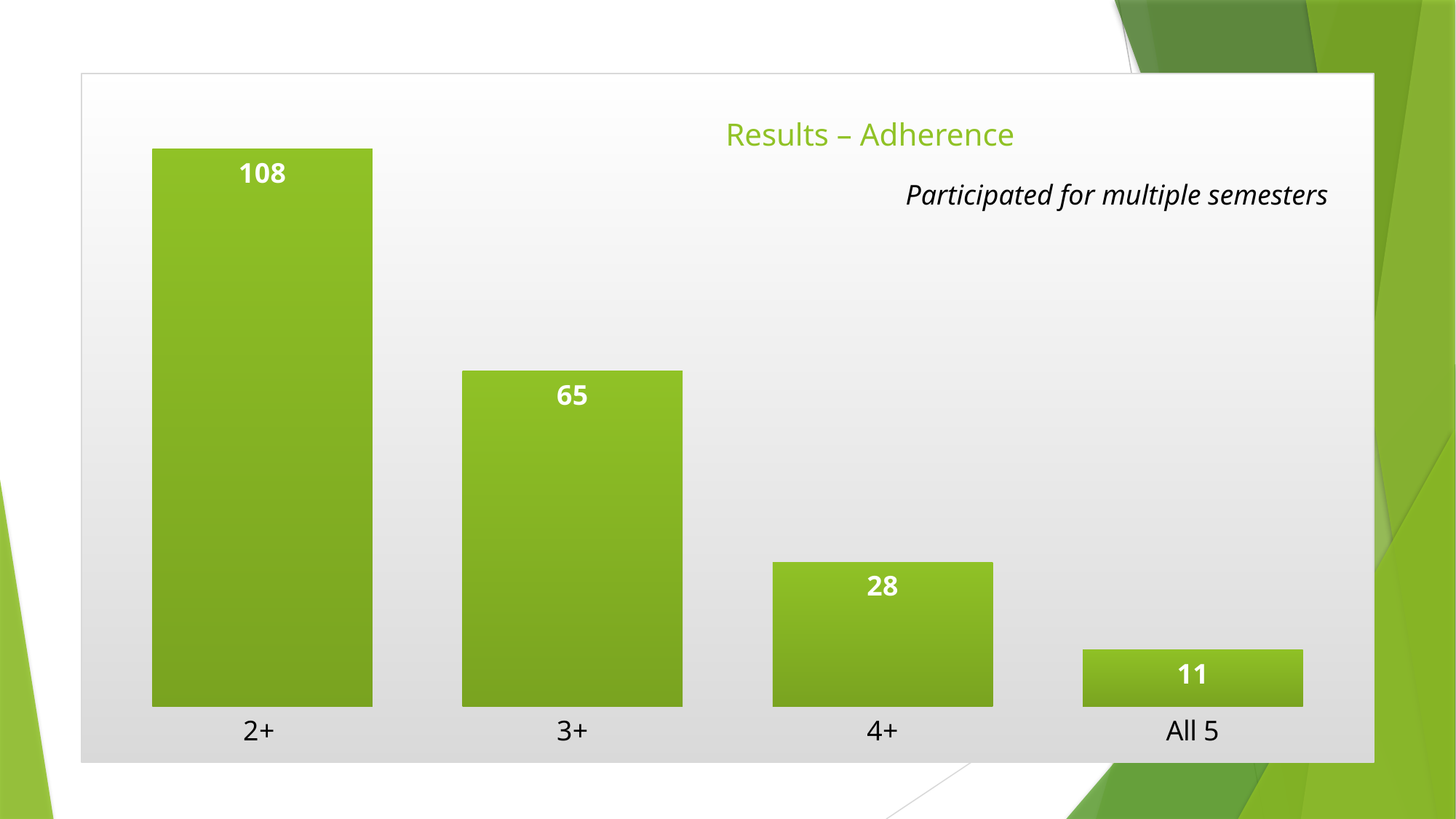
Which is larger, the value for 3+ or the value for 4+? 3+ What is the value for the All 5 category? 11 Which category has the lowest value? All 5 What is the value for the 2+ category? 108 What is the value for the 4+ category? 28 What kind of chart is shown on the slide? Bar chart What is the value for the 3+ category? 65 What is the difference between the values for 2+ and 3+? 43 How many categories are shown in the chart? 4 What is the difference between the values for 4+ and All 5? 17 Do the values rise or fall from left to right along the x axis? Fall Which category has the highest value? 2+